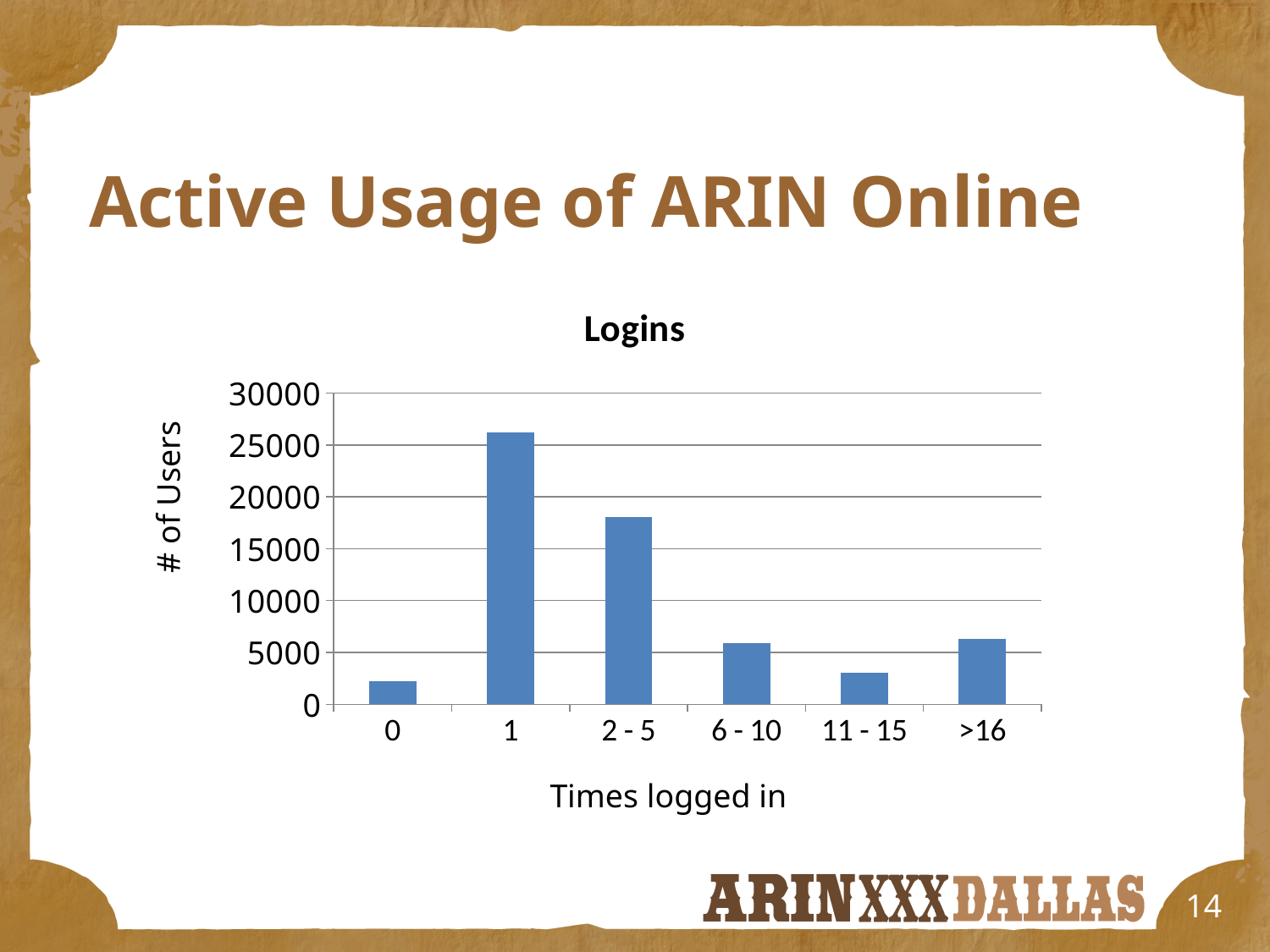
Is the number of users for the '2 - 5' category greater or less than 15000? greater What is the title of the chart? Logins How many categories are shown on the x axis? 6 Which has more users, the '2 - 5' category or the '6 - 10' category? 2 - 5 Which category has the highest number of users? 1 Which has more users, the '1' category or the '2 - 5' category? 1 What is the label of the vertical axis? # of Users Is the number of users for the '>16' category greater or less than 5000? greater What type of chart is shown on the slide? bar chart Is the number of users for the '1' category greater or less than 25000? greater Which category has the lowest number of users? 0